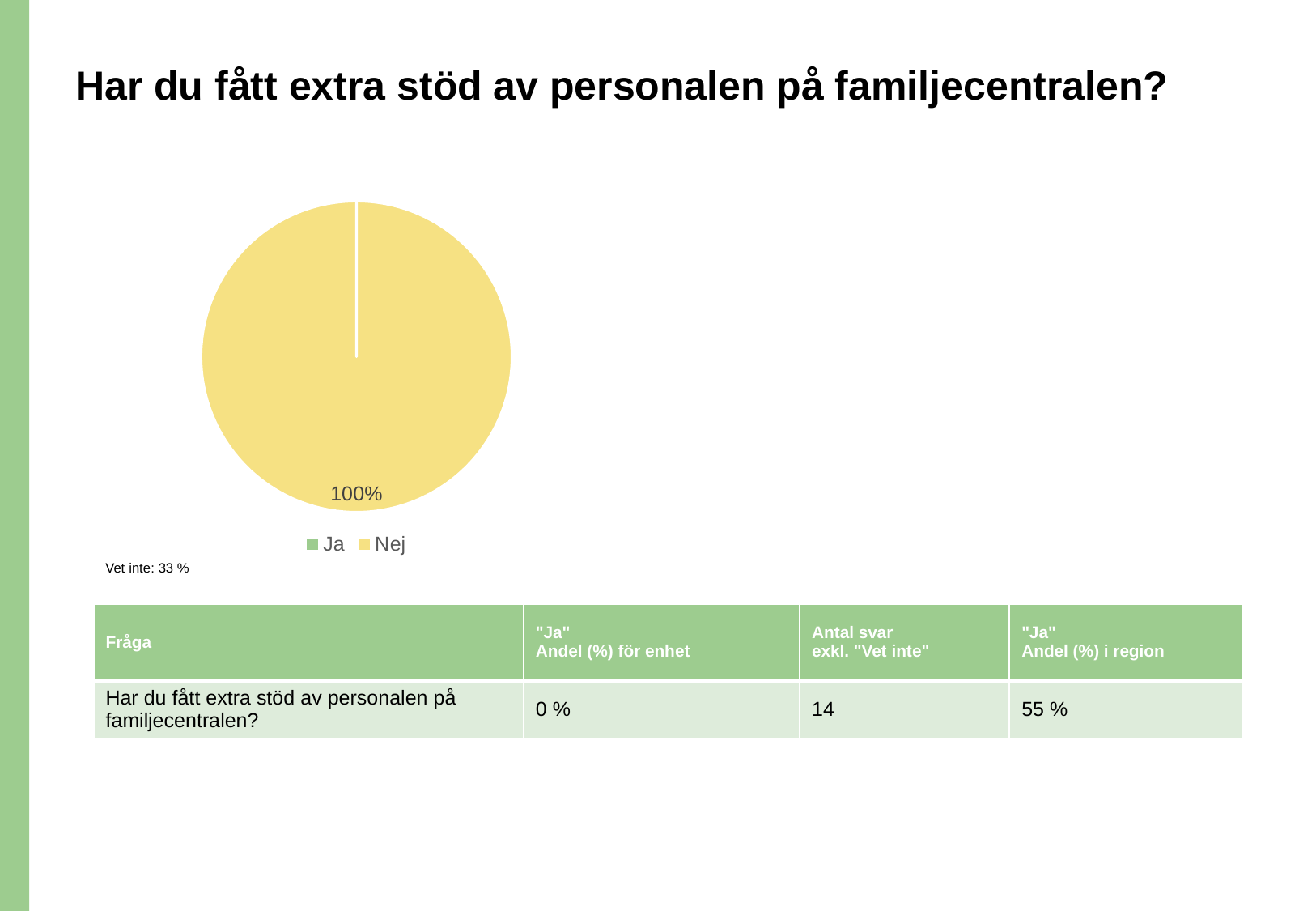
How many entries does the pie chart's legend list? 2 Which category has the largest slice in the pie chart? Nej Which category has the smallest slice in the pie chart? Ja What colour does the legend use for "Ja"? green Which is larger in the pie chart, the "Ja" slice or the "Nej" slice? Nej What colour is the "Nej" slice in the pie chart? yellow What percentage is given for "Vet inte" below the pie chart? 33 % What kind of chart is shown on the slide? pie chart What share of the pie does the "Nej" slice take? 100% Is the share of the "Nej" slice greater or less than 50%? greater